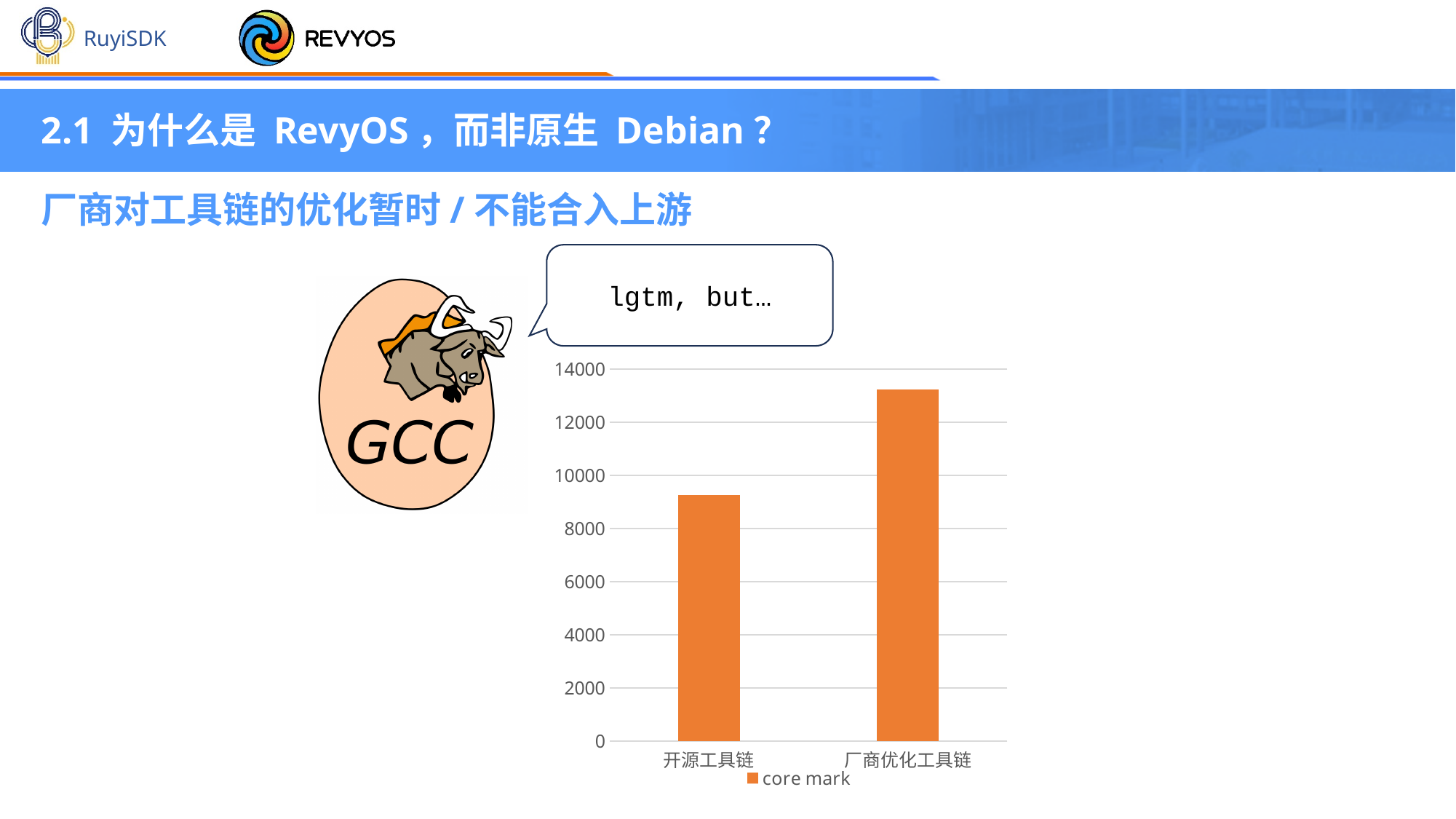
How many series does the chart legend list? 1 What is the name of the series shown in the chart legend? core mark How many categories are plotted on the x axis of the chart? 2 Is the core mark value for 开源工具链 greater or less than 10000? less Is the core mark value for 开源工具链 greater or less than 8000? greater What kind of chart is shown on the slide? bar chart Which is larger, the core mark for 开源工具链 or for 厂商优化工具链? 厂商优化工具链 Which category has the lowest core mark value? 开源工具链 Do the values rise or fall from 开源工具链 to 厂商优化工具链? rise Which category has the highest core mark value? 厂商优化工具链 Is the core mark value for 厂商优化工具链 greater or less than 12000? greater What is the highest value shown on the chart's y axis? 14000